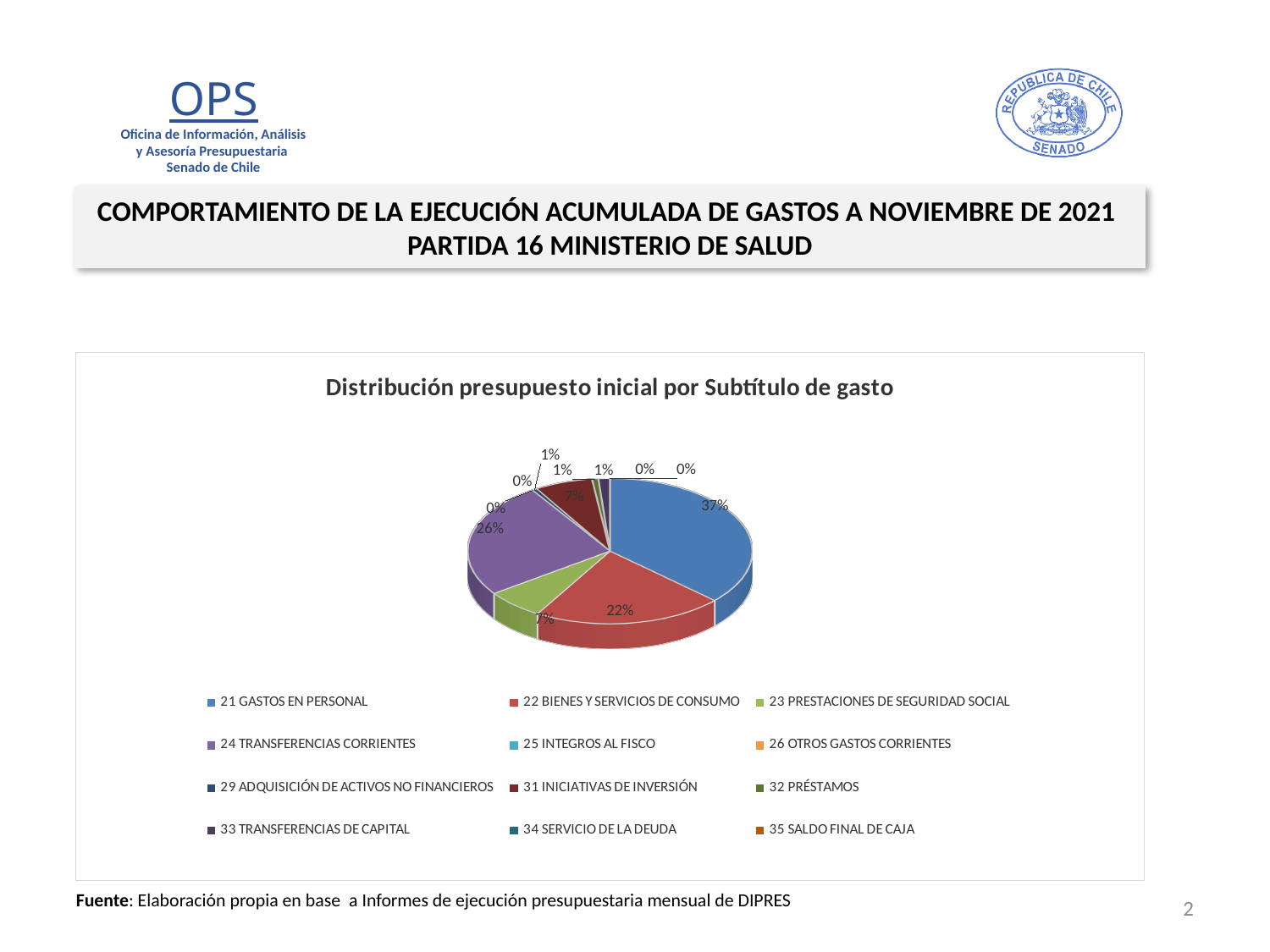
Which is larger, the share for 22 BIENES Y SERVICIOS DE CONSUMO or for 24 TRANSFERENCIAS CORRIENTES? 24 TRANSFERENCIAS CORRIENTES What is the difference in percentage points between the share for 21 GASTOS EN PERSONAL and the share for 24 TRANSFERENCIAS CORRIENTES? 11 percentage points What is the difference in percentage points between the share for 21 GASTOS EN PERSONAL and the share for 22 BIENES Y SERVICIOS DE CONSUMO? 15 percentage points What share of the pie does 22 BIENES Y SERVICIOS DE CONSUMO represent? 22% What is the title of the chart? Distribución presupuesto inicial por Subtítulo de gasto Which category has the largest share of the pie? 21 GASTOS EN PERSONAL What colour is the slice for 21 GASTOS EN PERSONAL? Blue What kind of chart is shown on the slide? Pie chart What share of the pie does 23 PRESTACIONES DE SEGURIDAD SOCIAL represent? 7% How many categories does the legend list? 12 What share of the pie does 24 TRANSFERENCIAS CORRIENTES represent? 26%